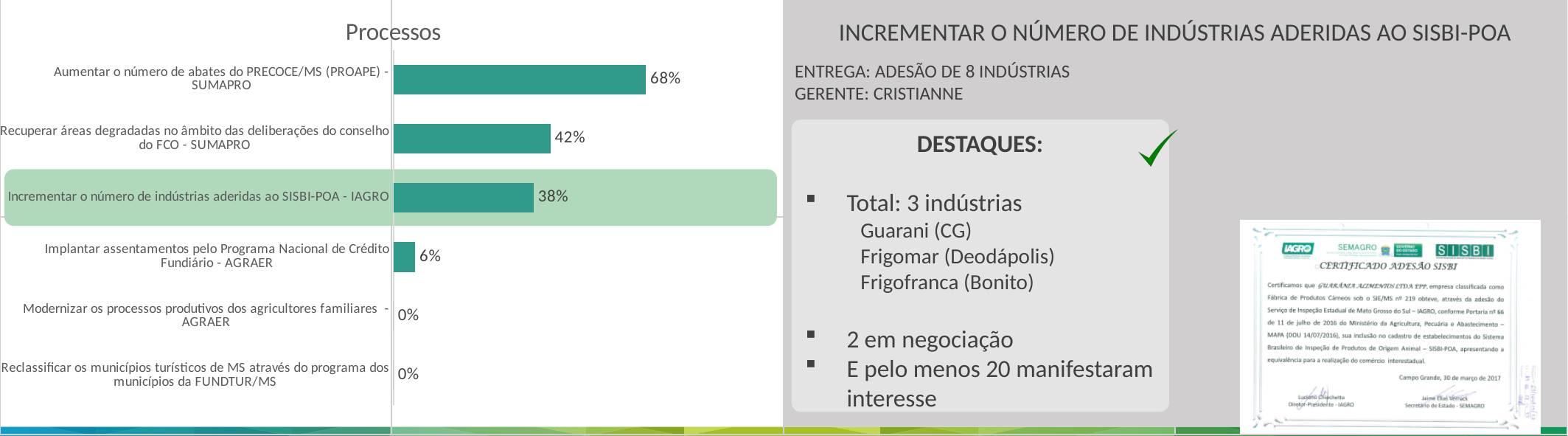
Which category has the highest value in the Processos chart? Aumentar o número de abates do PRECOCE/MS (PROAPE) - SUMAPRO How many categories in the Processos chart have a value of 0%? 2 What is the value for "Implantar assentamentos pelo Programa Nacional de Crédito Fundiário - AGRAER" in the Processos chart? 6% How many categories are shown in the Processos chart? 6 What kind of chart is the Processos chart? Bar chart What is the difference between the values for "Aumentar o número de abates do PRECOCE/MS (PROAPE) - SUMAPRO" and "Recuperar áreas degradadas no âmbito das deliberações do conselho do FCO - SUMAPRO" in the Processos chart? 26% What is the value for "Aumentar o número de abates do PRECOCE/MS (PROAPE) - SUMAPRO" in the Processos chart? 68% What is the value for "Modernizar os processos produtivos dos agricultores familiares - AGRAER" in the Processos chart? 0% What is the value for "Recuperar áreas degradadas no âmbito das deliberações do conselho do FCO - SUMAPRO" in the Processos chart? 42% What is the value for "Incrementar o número de indústrias aderidas ao SISBI-POA - IAGRO" in the Processos chart? 38% What is the title of the chart on the slide? Processos In the Processos chart, which is larger: the value for "Recuperar áreas degradadas no âmbito das deliberações do conselho do FCO - SUMAPRO" or for "Incrementar o número de indústrias aderidas ao SISBI-POA - IAGRO"? Recuperar áreas degradadas no âmbito das deliberações do conselho do FCO - SUMAPRO